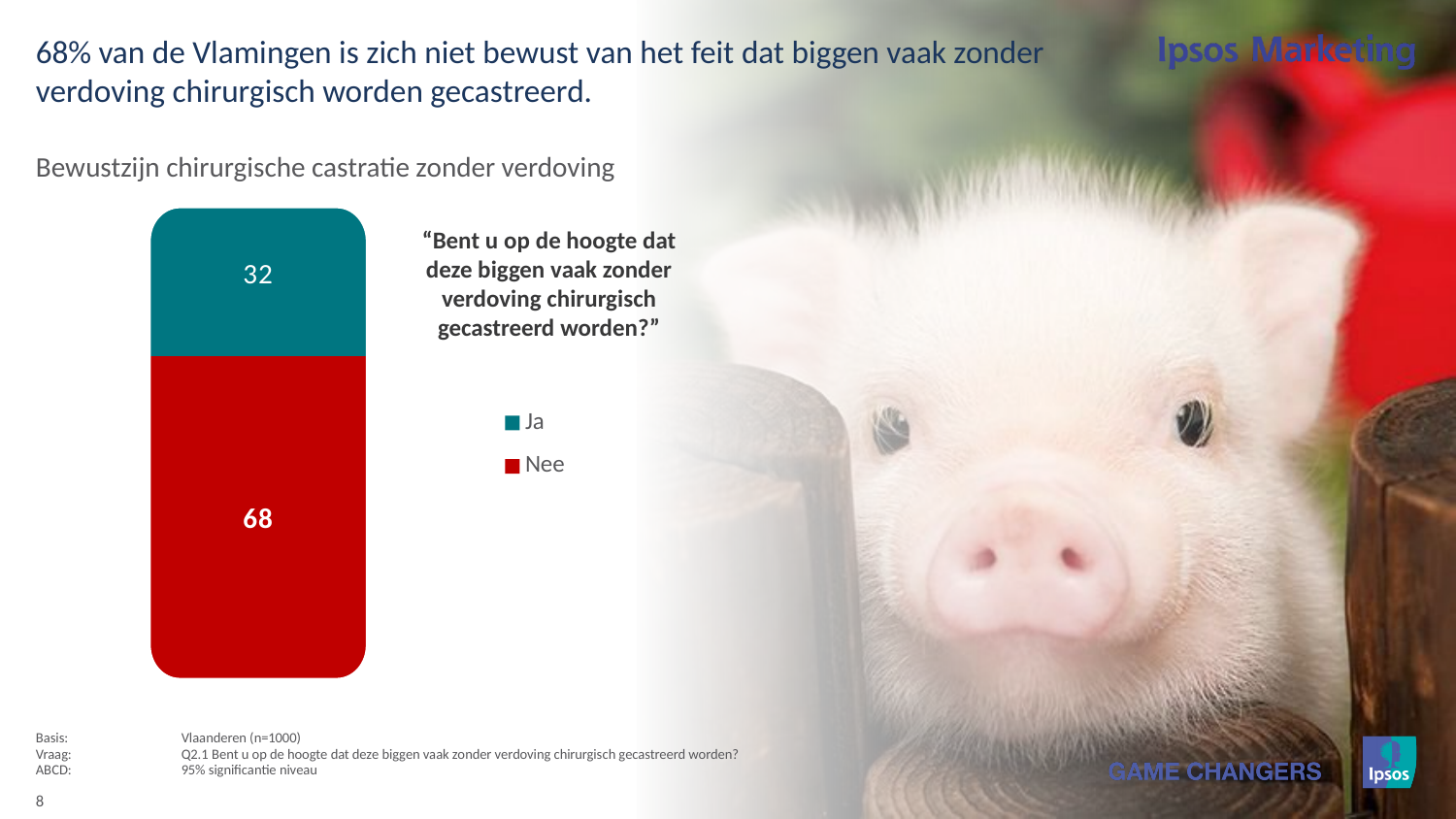
What is the value for "Nee" in the stacked bar? 68 Which colour represents "Ja" in the chart? Teal Which segment of the bar is larger, "Ja" or "Nee"? Nee Which legend entry has the largest value? Nee Which legend entry has the smallest value? Ja What is the value for "Ja" in the stacked bar? 32 What kind of chart is shown on the slide? Stacked bar chart Which colour represents "Nee" in the chart? Red How many segments does the stacked bar contain? 2 What is the total of the two segments in the stacked bar? 100 What is the difference between the "Nee" value and the "Ja" value? 36 How many series does the legend list? 2